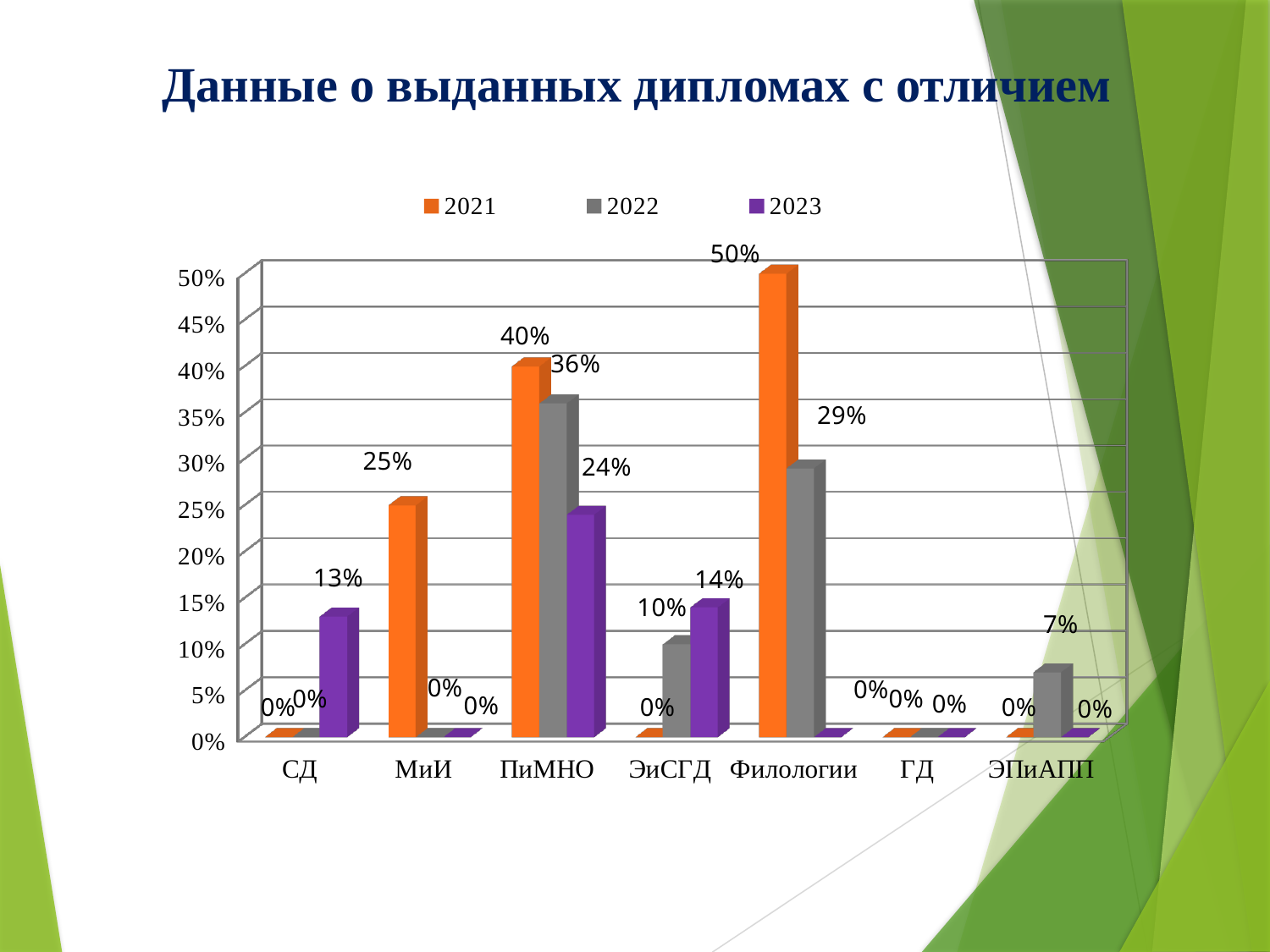
How many categories are shown on the x axis? 7 What is the title of the chart on the slide? Данные о выданных дипломах с отличием How many series does the legend list? 3 What is the value for ЭПиАПП in the 2022 series? 7% Which category has the highest value in the 2021 series? Филологии Which category has the highest value in the 2023 series? ПиМНО What kind of chart is shown on the slide? Bar chart What is the value for Филологии in the 2021 series? 50% Which is larger for ЭиСГД: the 2022 value or the 2023 value? 2023 What is the value for СД in the 2023 series? 13% What is the value for ПиМНО in the 2022 series? 36% What is the difference between the 2021 and 2022 values for Филологии? 21%